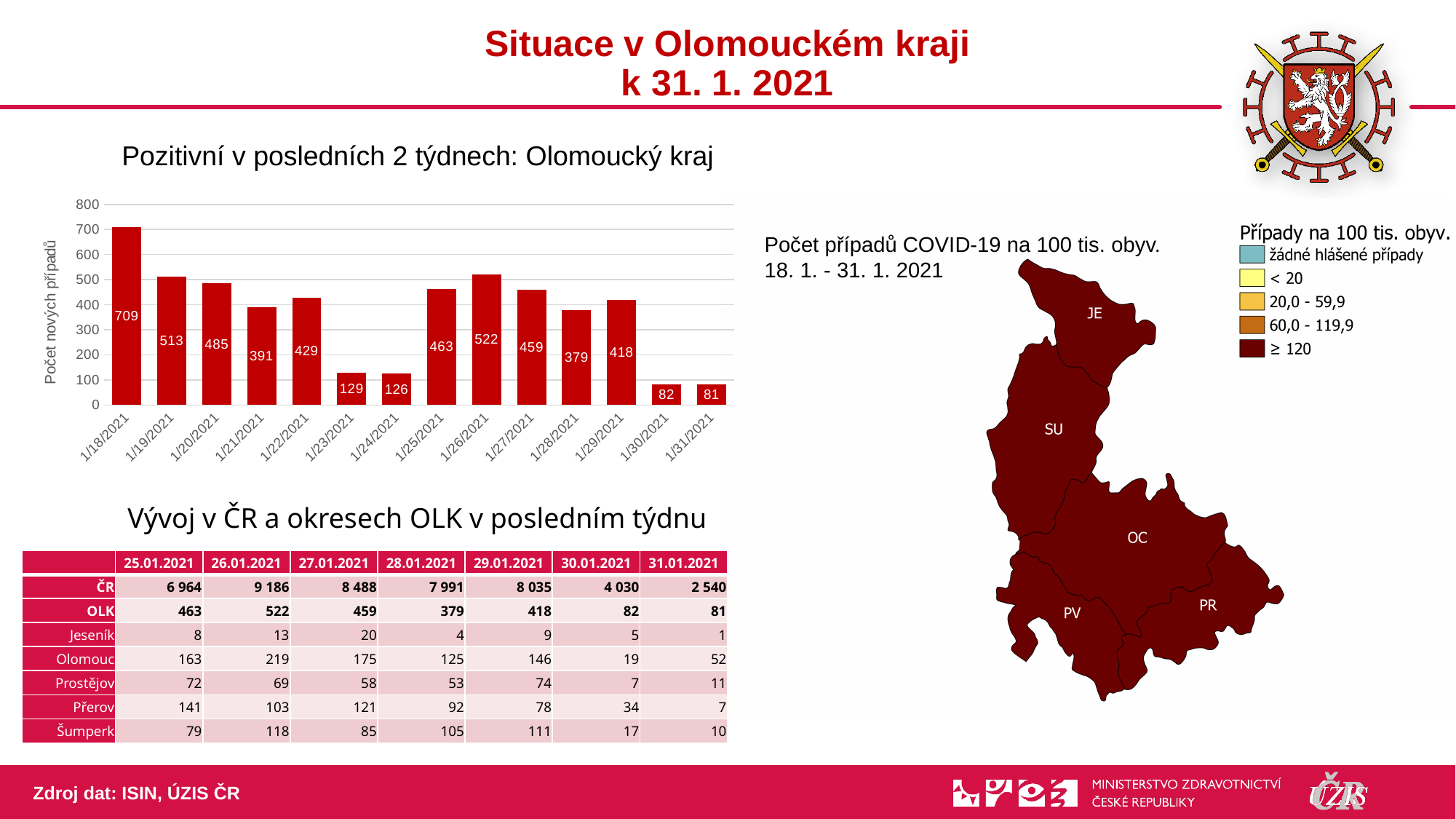
What type of chart is shown under the heading 'Pozitivní v posledních 2 týdnech: Olomoucký kraj'? bar chart In the bar chart, what is the value for 1/24/2021? 126 In the bar chart, which is larger: the value for 1/22/2021 or the value for 1/21/2021? 1/22/2021 In the bar chart, what is the difference between the values for 1/19/2021 and 1/20/2021? 28 Which date has the highest value in the bar chart? 1/18/2021 In the bar chart, what is the value for 1/18/2021? 709 In the bar chart, is the value for 1/25/2021 greater or less than 400? greater Which date has the lowest value in the bar chart? 1/31/2021 In the bar chart, what is the value for 1/26/2021? 522 How many dates (bars) are shown in the bar chart? 14 In the bar chart, do the values rise or fall from 1/29/2021 to 1/31/2021? fall What is the label of the vertical axis of the bar chart? Počet nových případů